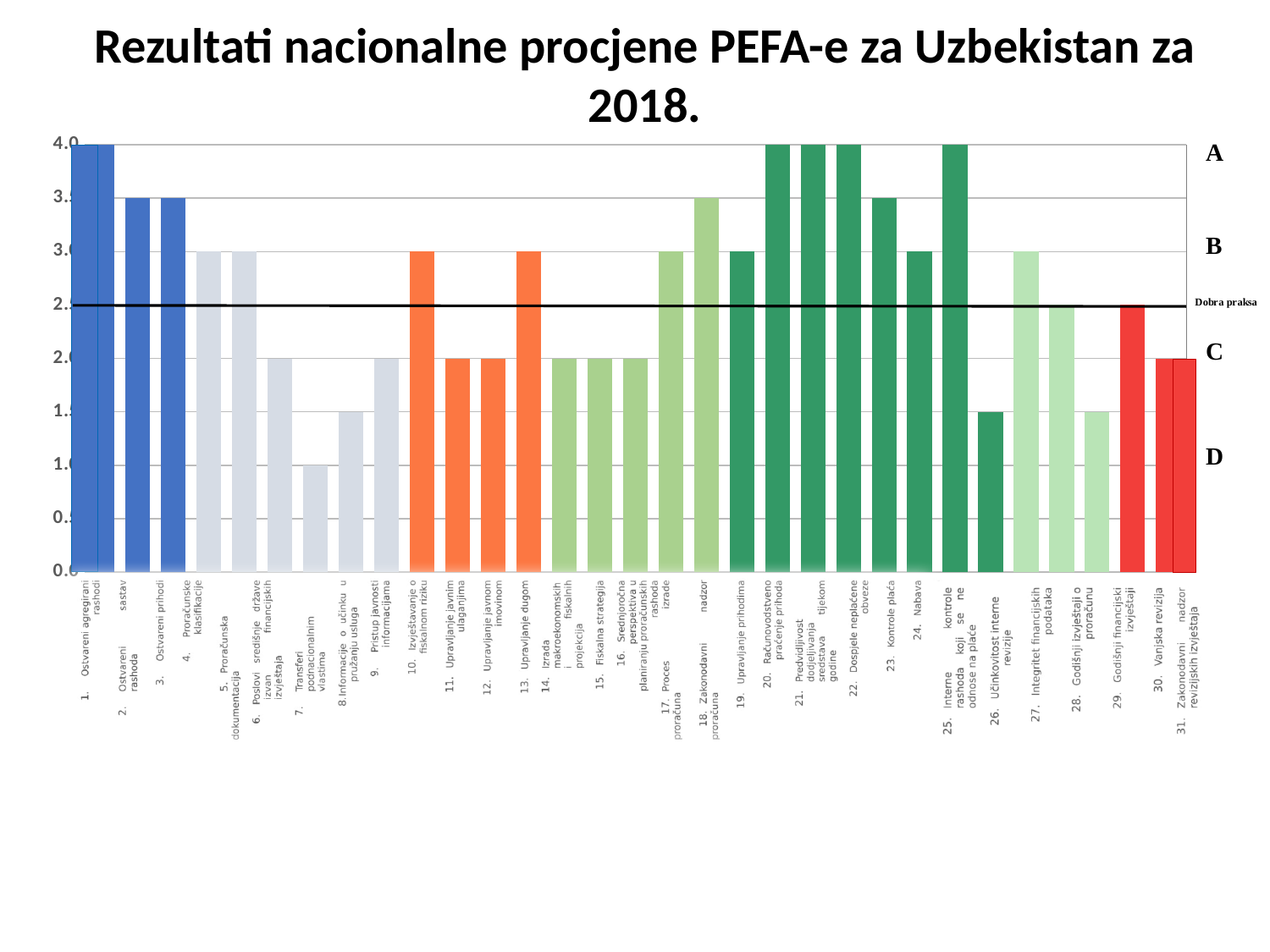
Is the value for '7. Transferi podnacionalnim vlastima' greater or less than 4.0? less How many categories (indicators) are plotted along the x axis? 31 What is the value for '1. Ostvareni agregirani rashodi'? 4.0 Which category has the lowest value? 7. Transferi podnacionalnim vlastima Which is larger, the value for '1. Ostvareni agregirani rashodi' or the value for '7. Transferi podnacionalnim vlastima'? 1. Ostvareni agregirani rashodi Which is larger, the value for '26. Učinkovitost interne revizije' or the value for '22. Dospjele neplaćene obveze'? 22. Dospjele neplaćene obveze What kind of chart is shown on the slide? Bar chart What is the title of the chart on the slide? Rezultati nacionalne procjene PEFA-e za Uzbekistan za 2018. What is the value for '20. Računovodstveno praćenje prihoda'? 4.0 What is the value for '25. Interne kontrole rashoda koji se ne odnose na plaće'? 4.0 What label is given to the horizontal black line drawn across the chart? Dobra praksa Is the bar for '29. Godišnji financijski izvještaji' above or below the 'Dobra praksa' line? below